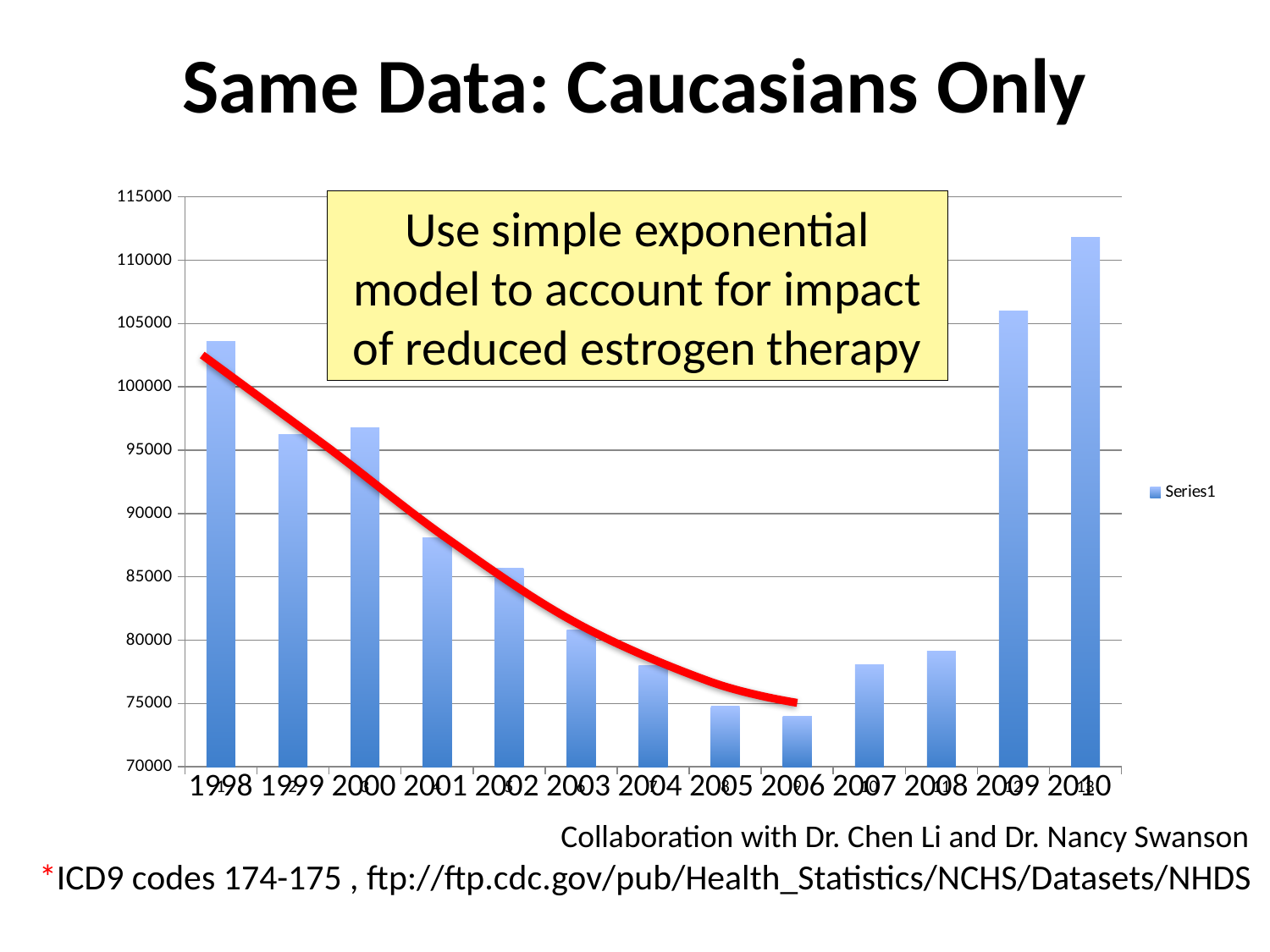
Which is larger, the value for 2001 or the value for 2008? 2001 Which is larger, the value for 1998 or the value for 1999? 1998 Is the value for 2006 greater or less than 75000? less How many series does the chart legend list? 1 Which year has the highest bar on the chart? 2010 How many years (bars) are plotted on the chart? 13 What is the name of the series shown in the chart legend? Series1 What kind of chart is shown on the slide? bar chart Is the value for 2001 greater or less than 90000? less Is the value for 2009 greater or less than 105000? greater Do the bar values rise or fall from 1998 to 2006? fall